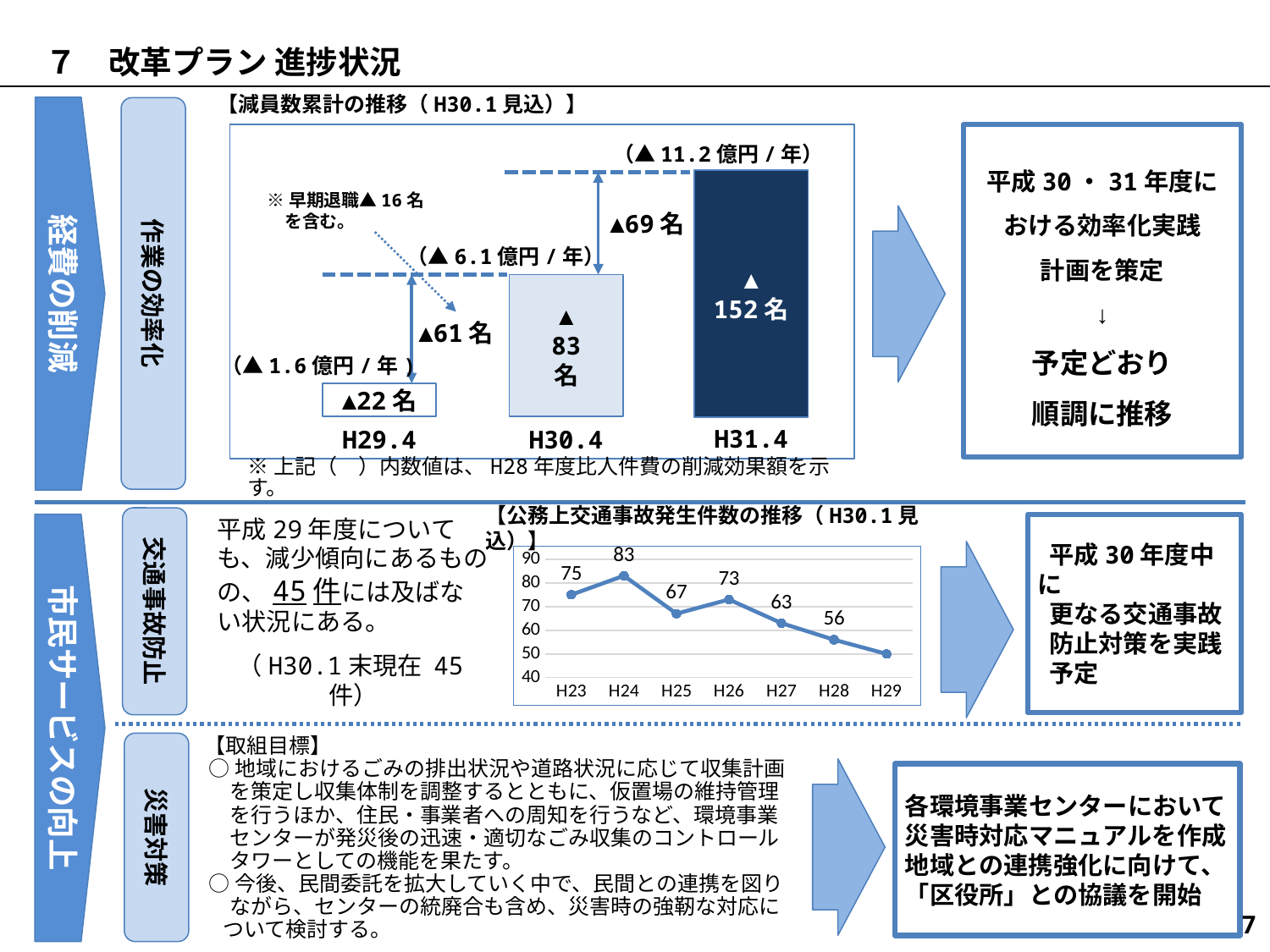
In the chart titled 公務上交通事故発生件数の推移, which year has the highest value? H24 What kind of chart is the 減員数累計の推移 chart? bar chart In the chart titled 公務上交通事故発生件数の推移, what is the value for H28? 56 In the chart titled 減員数累計の推移, what is the value shown for H30.4? ▲83名 In the chart titled 減員数累計の推移, what is the value shown for H31.4? ▲152名 In the chart titled 減員数累計の推移, which category has the largest value? H31.4 In the chart titled 公務上交通事故発生件数の推移, what is the difference between the values for H24 and H25? 16 What kind of chart is the 公務上交通事故発生件数の推移 chart? line chart In the chart titled 公務上交通事故発生件数の推移, what is the value for H24? 83 In the chart titled 減員数累計の推移, how many categories are shown on the x axis? 3 In the chart titled 減員数累計の推移, what is the value shown for H29.4? ▲22名 In the chart titled 公務上交通事故発生件数の推移, is the value for H29 greater or less than 60? less